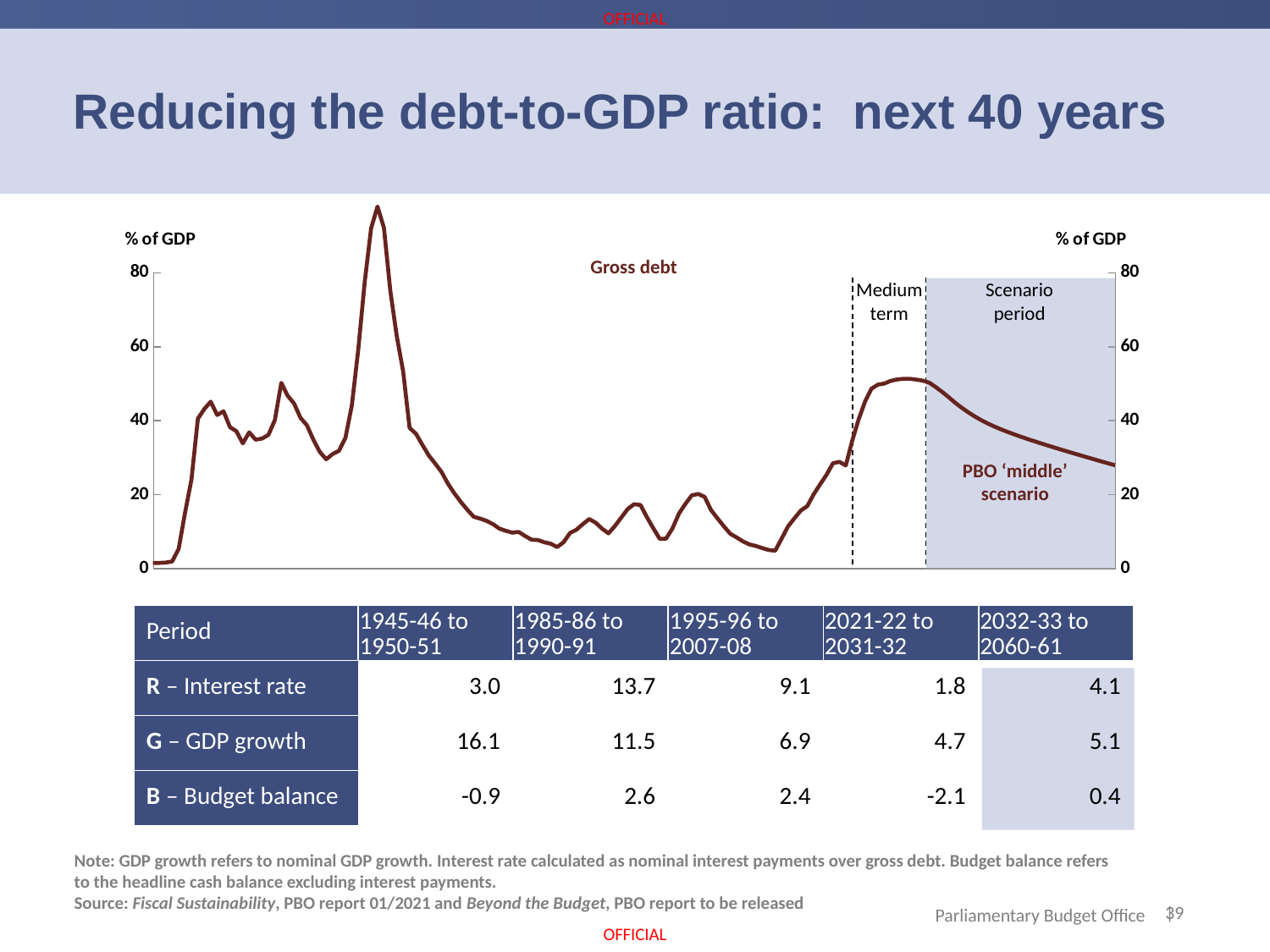
Does gross debt rise or fall across the medium term section of the chart? rise In the table, what is the interest rate for the period 1985-86 to 1990-91? 13.7 Is the value of gross debt at the start of the scenario period greater or less than 40? greater Does gross debt rise or fall across the shaded scenario period? fall What series does the line in the chart represent? Gross debt What is the highest tick value shown on the chart's vertical axis? 80 Is the peak value of gross debt in the chart greater or less than 60? greater Is the value of gross debt at the end of the scenario period greater or less than 40? less What unit is shown on the chart's vertical axes? % of GDP Which scenario is labelled in the shaded area of the chart? PBO 'middle' scenario What kind of chart is shown on the slide? line chart In the table, what is the budget balance for the period 2032-33 to 2060-61? 0.4